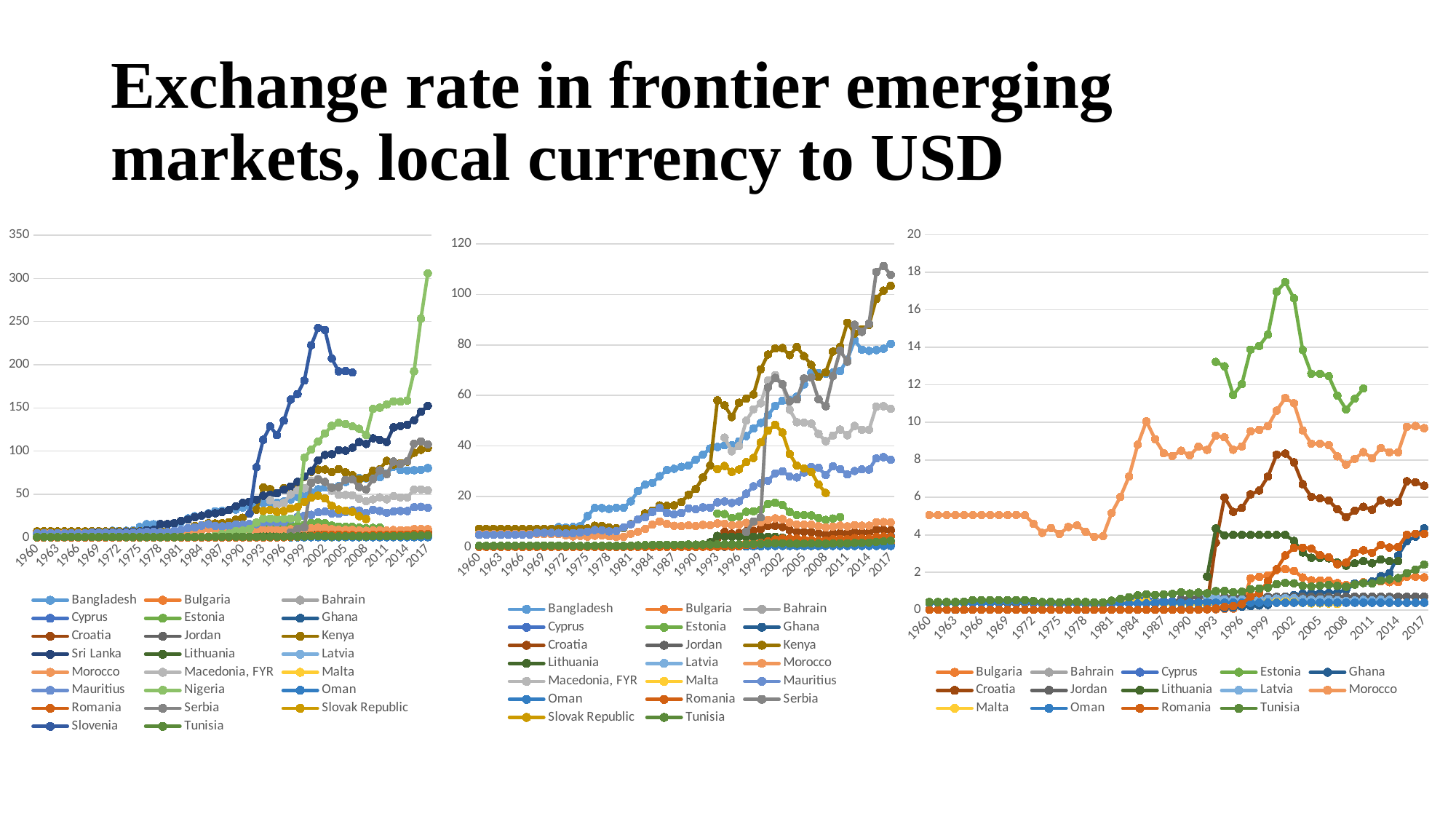
In the left chart, is the value for Nigeria in 2017 greater or less than 250? greater How many series does the legend of the right chart list? 14 How many series does the legend of the left chart list? 23 In the right chart, which series reaches the highest value? Estonia In the right chart, which is larger in 2017, Morocco or Croatia? Morocco In the right chart, is the value for Morocco in 1960 greater or less than 6? less In the left chart, is the peak value for Slovenia around 2001 greater or less than 200? greater What kind of chart is the left chart on the slide? line chart What is the title of the slide? Exchange rate in frontier emerging markets, local currency to USD In the right chart, does the value for Estonia rise or fall between 2001 and 2009? fall How many series does the legend of the middle chart list? 20